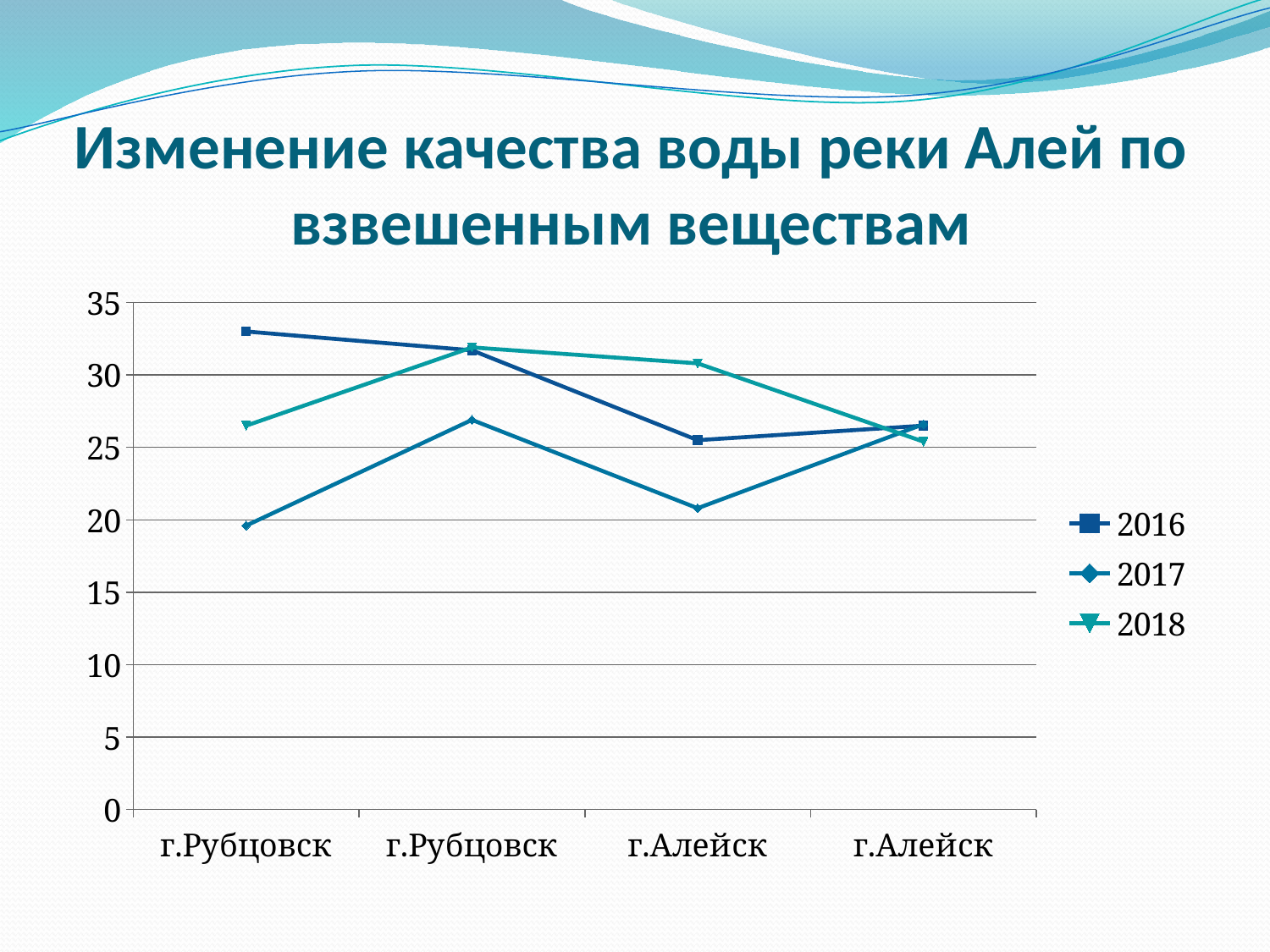
What kind of chart is shown on the slide? line chart At the second point (г.Рубцовск), which is larger: the 2016 value or the 2017 value? 2016 Which series has the highest value at the first point (г.Рубцовск)? 2016 Which series has the lowest value at the first point (г.Рубцовск)? 2017 Is the value of the 2016 series at the first point (г.Рубцовск) greater or less than 30? greater How many series does the legend list? 3 Is the value of the 2017 series at the first point (г.Рубцовск) greater or less than 25? less Which years are listed in the legend? 2016, 2017, 2018 How many points are plotted along the x axis for each series? 4 Is the value of the 2017 series at the third point (г.Алейск) greater or less than 25? less Which series has the lowest value at the third point (г.Алейск)? 2017